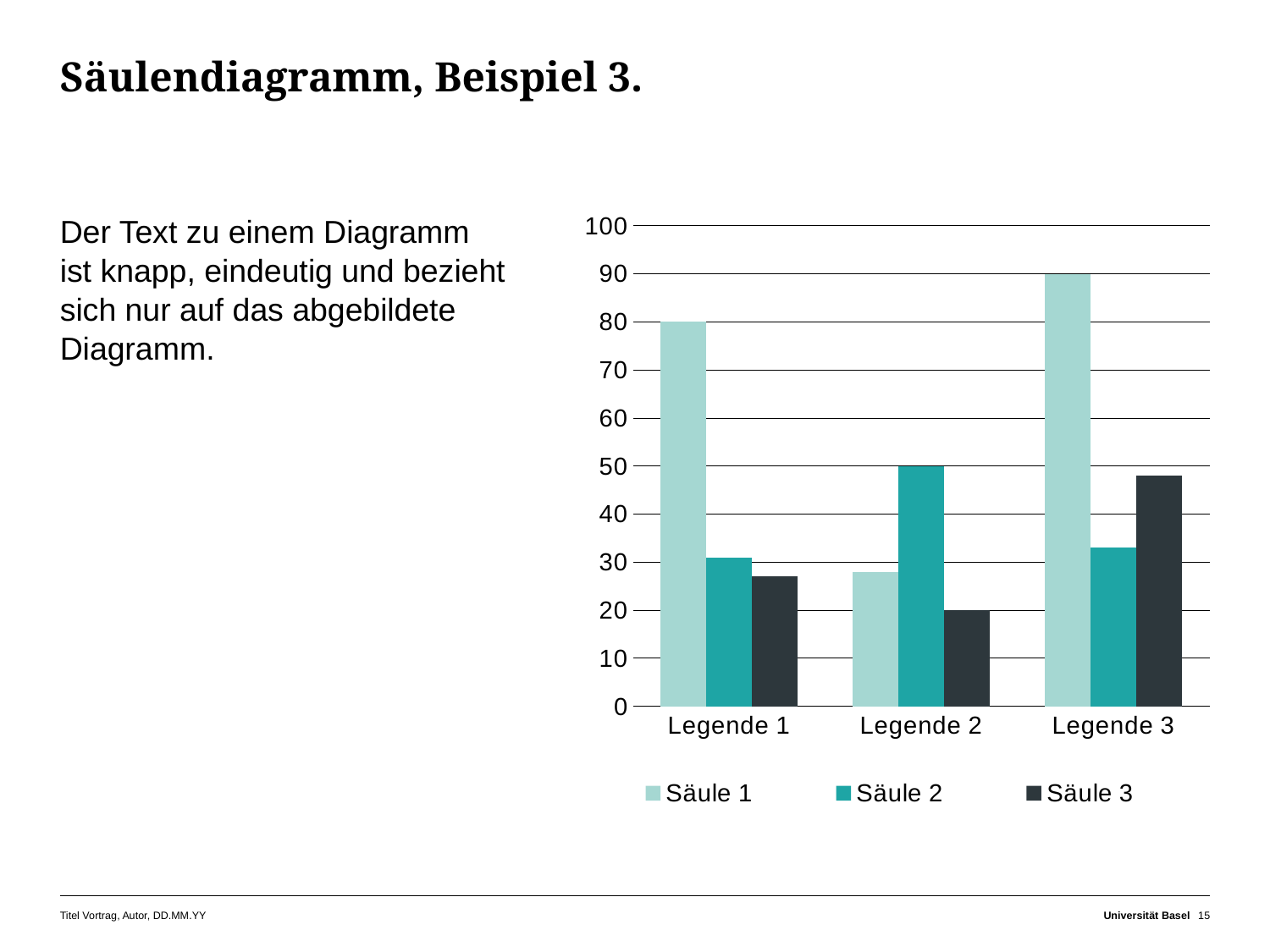
For Legende 3, which is larger: Säule 2 or Säule 3? Säule 3 Is the value of Säule 1 for Legende 2 greater or less than 30? less Which category has the highest Säule 1 value? Legende 3 What is the value of Säule 1 for Legende 3? 90 What is the difference between the Säule 1 values for Legende 3 and Legende 1? 10 How many categories are shown on the x axis? 3 How many series does the legend list? 3 What is the value of Säule 2 for Legende 2? 50 What is the value of Säule 3 for Legende 2? 20 What is the value of Säule 1 for Legende 1? 80 Which category has the lowest Säule 3 value? Legende 2 Is the value of Säule 3 for Legende 3 greater or less than 40? greater